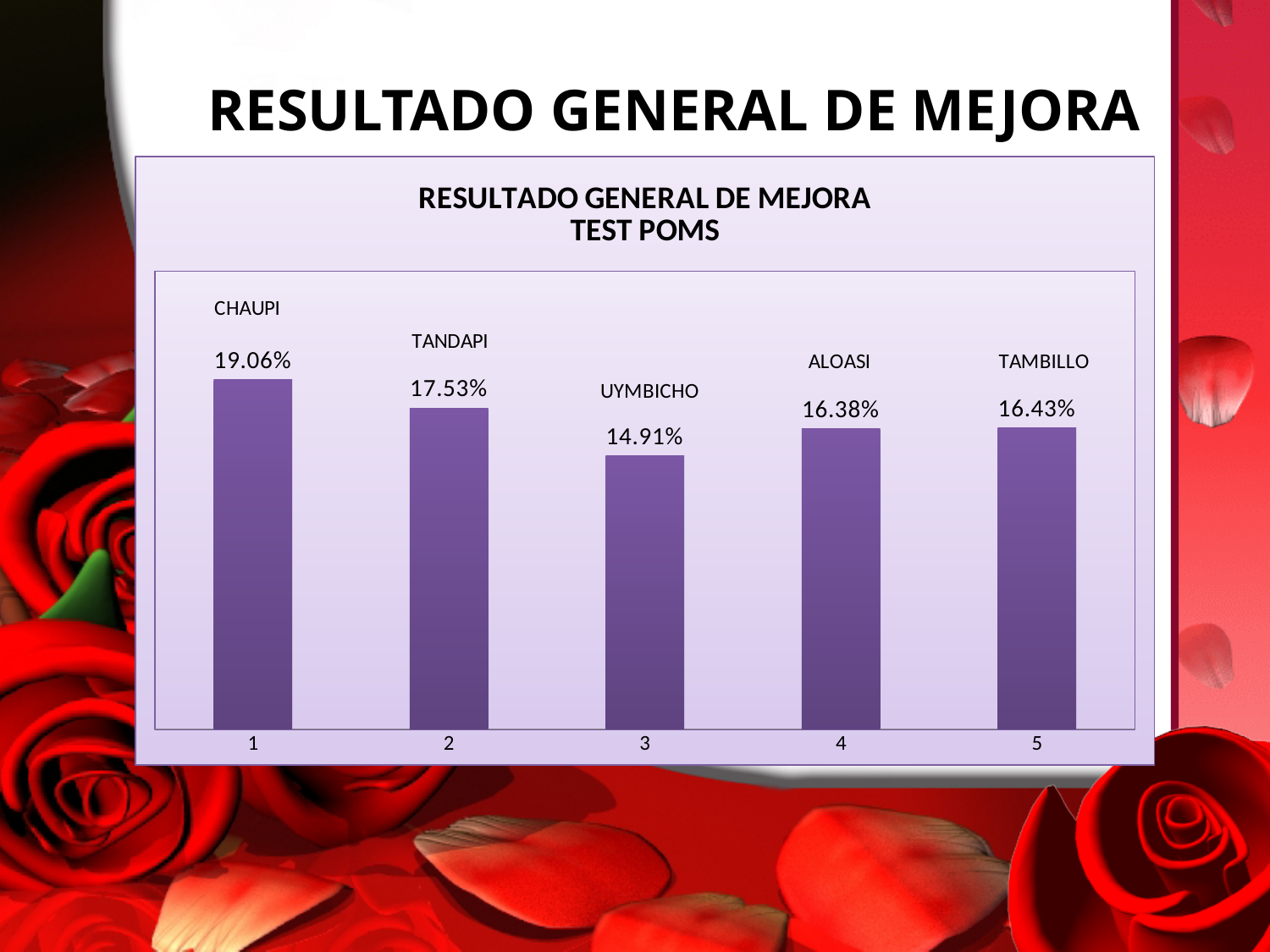
What is the value for CHAUPI? 19.06% What is the value for ALOASI? 16.38% How many bars are shown in the chart? 5 Which category has the lowest value? UYMBICHO Which is larger, the value for TANDAPI or the value for UYMBICHO? TANDAPI What is the title of the chart? RESULTADO GENERAL DE MEJORA TEST POMS What is the difference between the values for TANDAPI and UYMBICHO? 2.62% What is the value for UYMBICHO? 14.91% What is the value for TAMBILLO? 16.43% Which category has the highest value? CHAUPI What is the difference between the values for CHAUPI and TANDAPI? 1.53% What kind of chart is shown on the slide? Bar chart